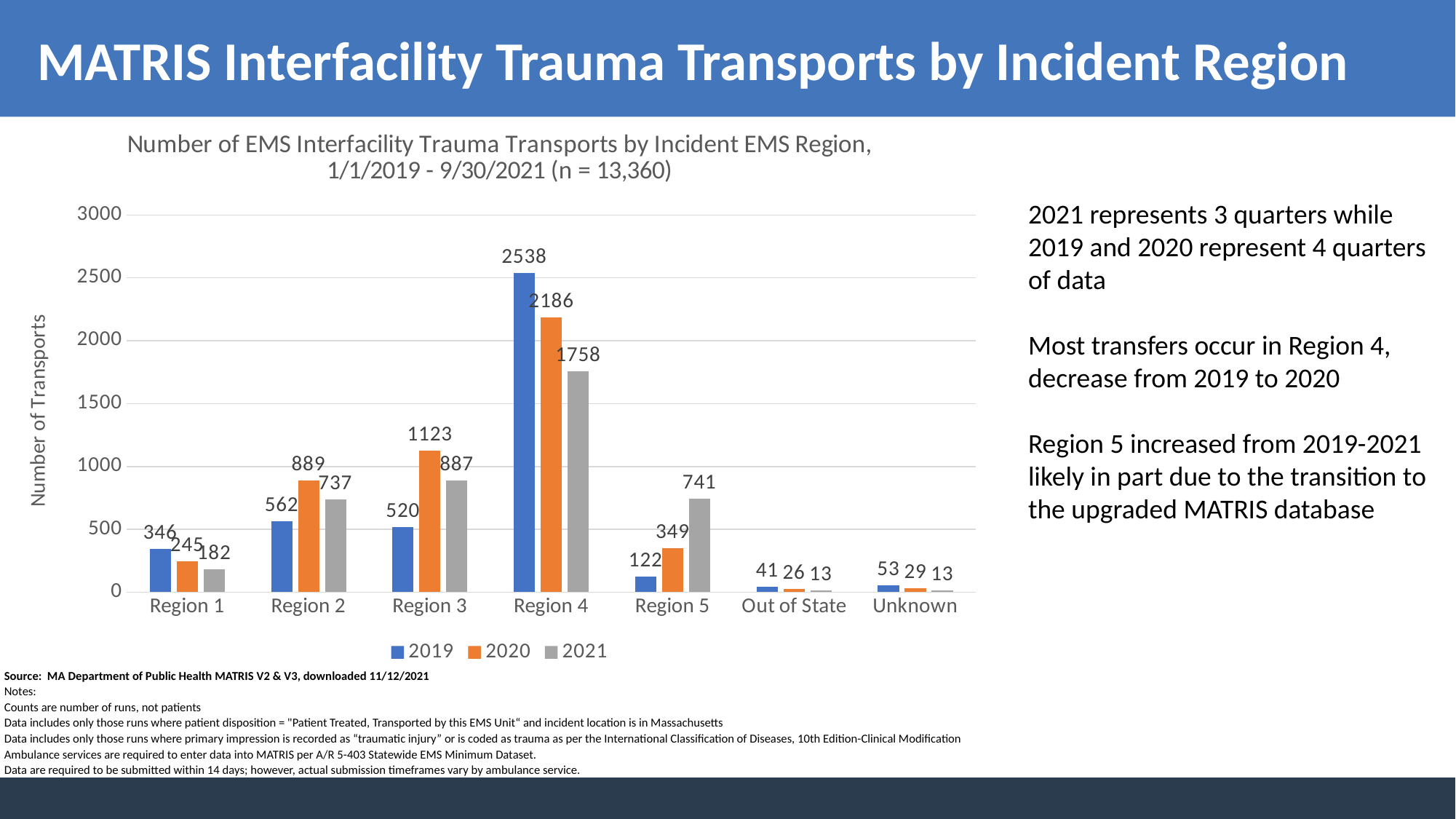
How many categories are shown on the x axis? 7 Which region has the highest value for 2020? Region 4 What is the value for Region 4 in 2019? 2538 Which is larger for Region 2: the 2020 value or the 2021 value? 2020 Is the value for Region 3 in 2021 greater or less than 1000? less What is the value for Region 3 in 2020? 1123 Which category has the lowest value for 2019? Out of State What is the label of the y axis? Number of Transports How many series does the legend list? 3 What is the difference between the 2019 and 2020 values for Region 4? 352 What kind of chart is shown? bar chart What is the value for Region 5 in 2021? 741